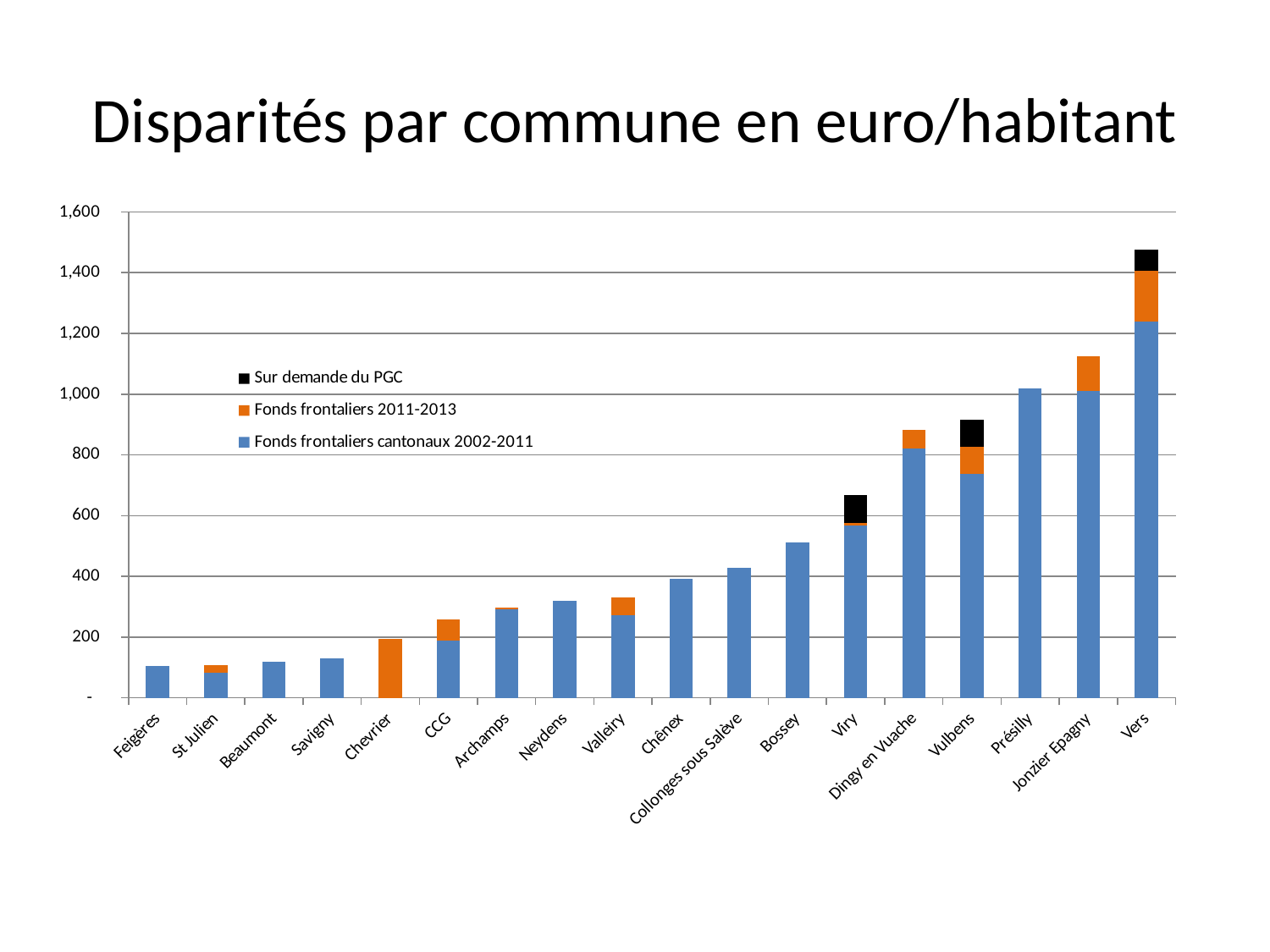
Is the total value for Bossey greater or less than 600? less What kind of chart is shown on the slide? Stacked bar chart Is the total value for Neydens greater or less than 400? less How many communes (categories) are shown on the x axis? 18 Which colour represents the series 'Sur demande du PGC' in the legend? Black Do the total bar values generally rise or fall from left to right along the x axis? Rise Which has the larger total bar, Bossey or Neydens? Bossey Which commune has the highest total bar? Vers How many series does the legend list? 3 Is the total value for Dingy en Vuache greater or less than 800? greater